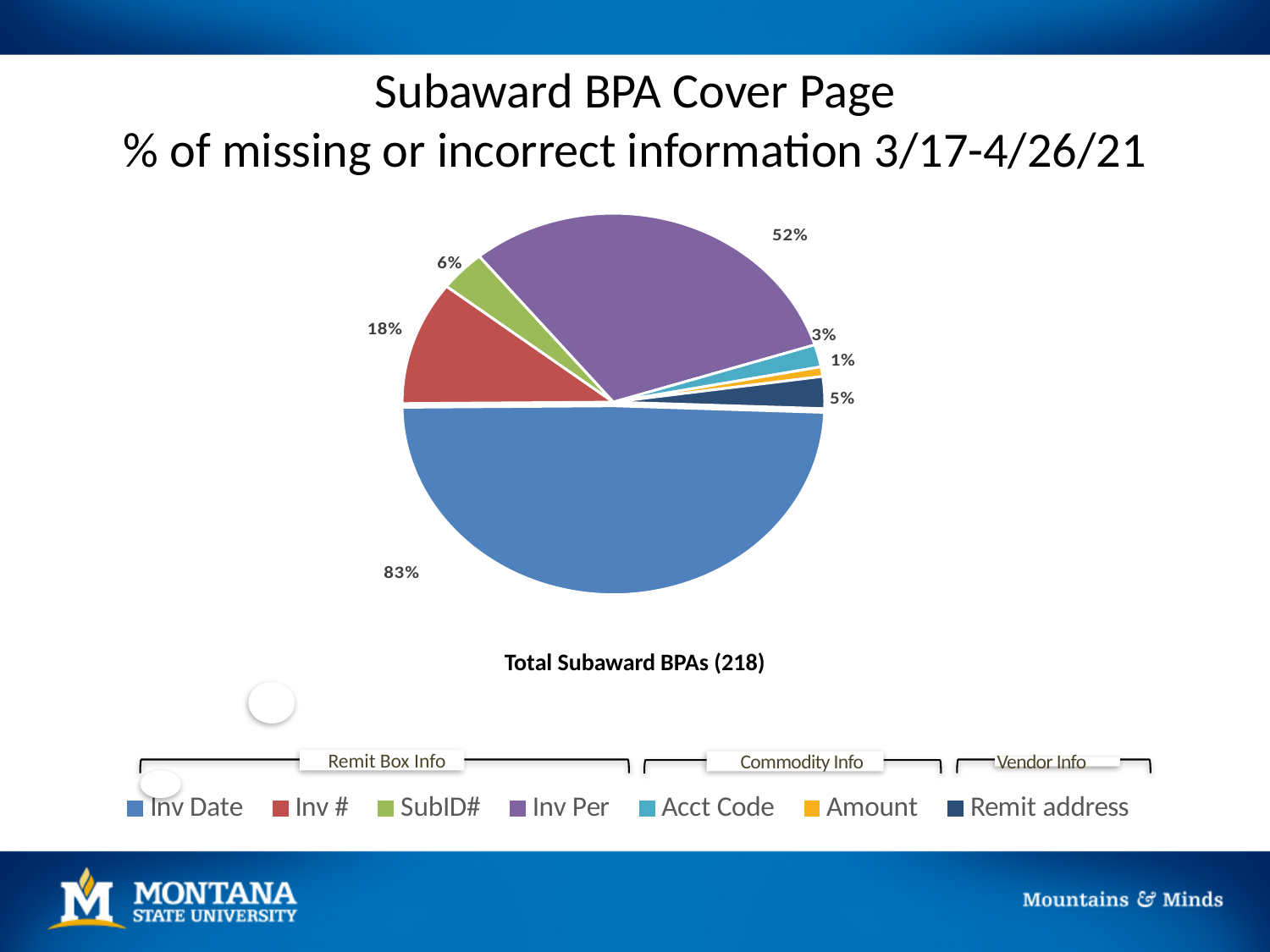
What type of chart is shown on the slide? Pie chart Which category has the smallest slice of the pie? Amount Which category has the largest slice of the pie? Inv Date How many categories does the legend list? 7 Which is larger, the value for Inv # or the value for SubID#? Inv # What percentage is shown for Inv Date? 83% What is the difference in percentage points between Inv Date and Inv Per? 31 What percentage is shown for Remit address? 5% What percentage is shown for Inv #? 18% What percentage is shown for Inv Per? 52% What percentage is shown for SubID#? 6% What percentage is shown for Amount? 1%